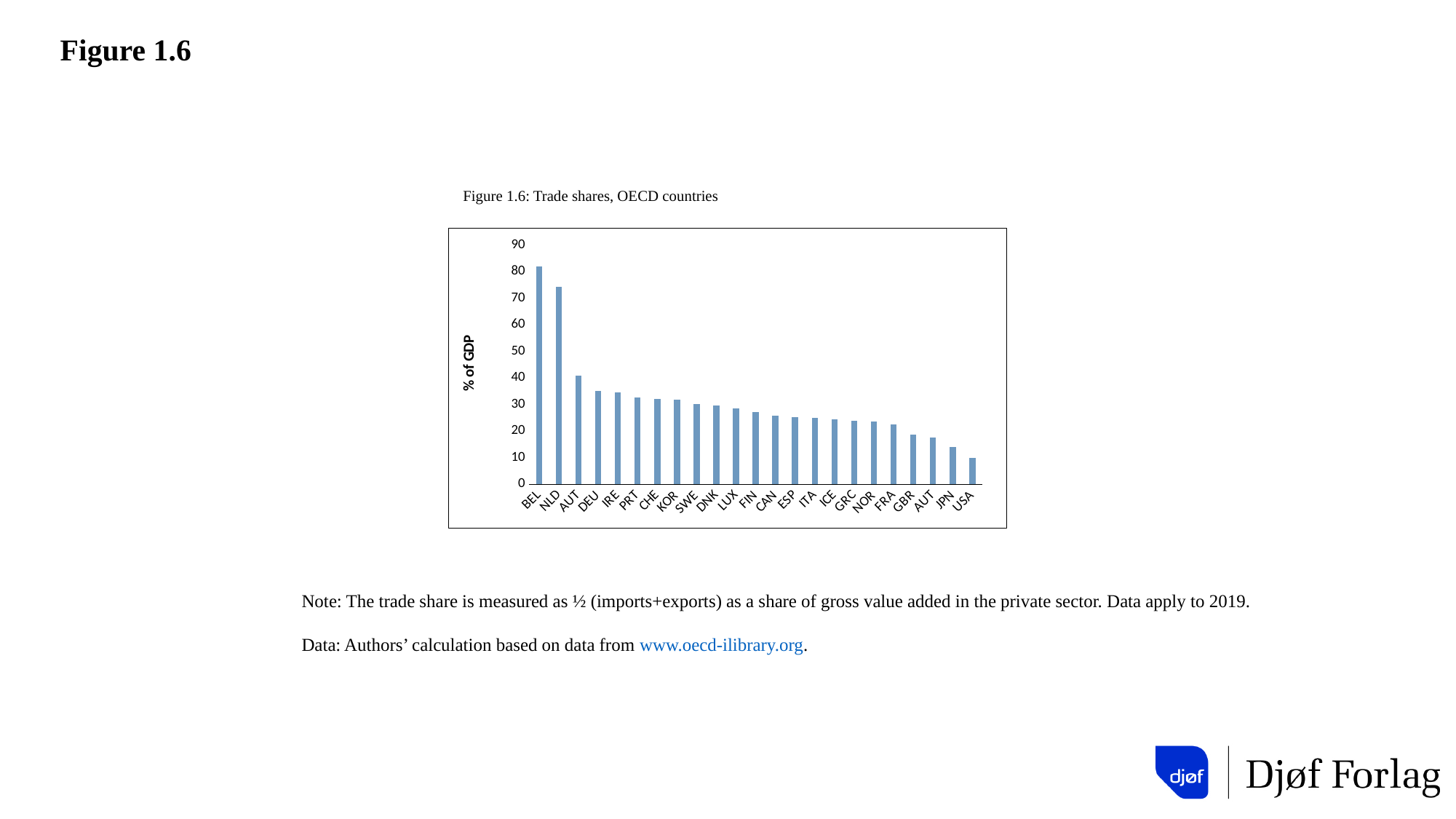
What is the label on the vertical axis of the chart? % of GDP Which has a larger trade share, BEL or NLD? BEL How many countries (bars) are shown in the chart? 23 Is the value for BEL greater or less than 70? greater Do the bar values rise or fall from left to right along the x axis? fall What kind of chart is shown on the slide? bar chart Is the value for NLD greater or less than 70? greater Is the value for JPN greater or less than 20? less Which country has the lowest trade share in the chart? USA Which country has the highest trade share in the chart? BEL